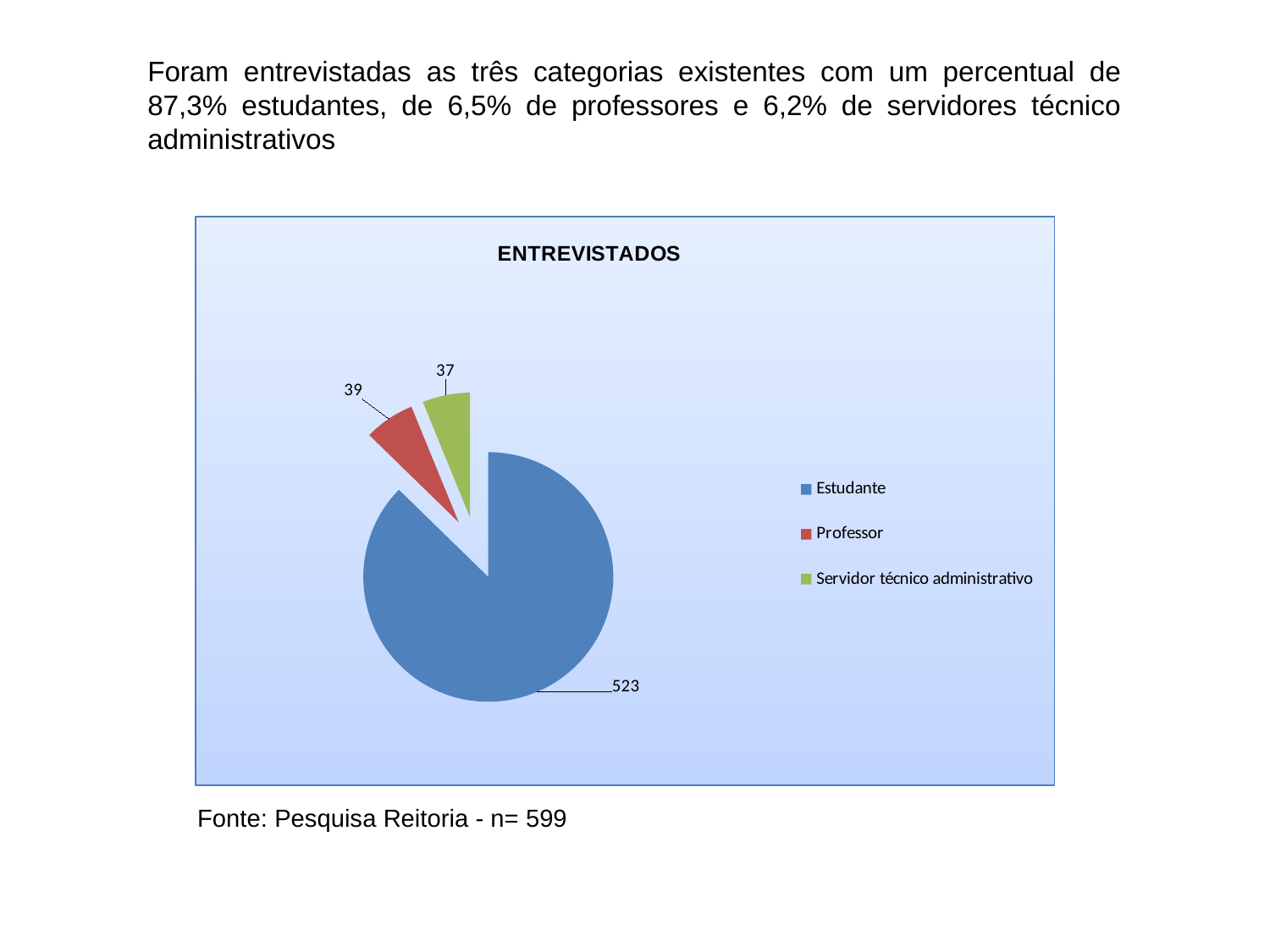
What type of chart is shown on the slide? Pie chart What is the difference between the value for Estudante and the value for Professor? 484 Which category has the smallest slice of the pie chart? Servidor técnico administrativo What is the value for Professor in the pie chart? 39 What share of the pie does the Estudante slice represent? 87,3% How many entries does the chart legend list? 3 What is the value for Estudante in the pie chart? 523 How many slices does the pie chart have? 3 What is the title of the chart? ENTREVISTADOS What is the value for Servidor técnico administrativo in the pie chart? 37 Which is larger, the value for Professor or the value for Servidor técnico administrativo? Professor Which category has the largest slice of the pie chart? Estudante